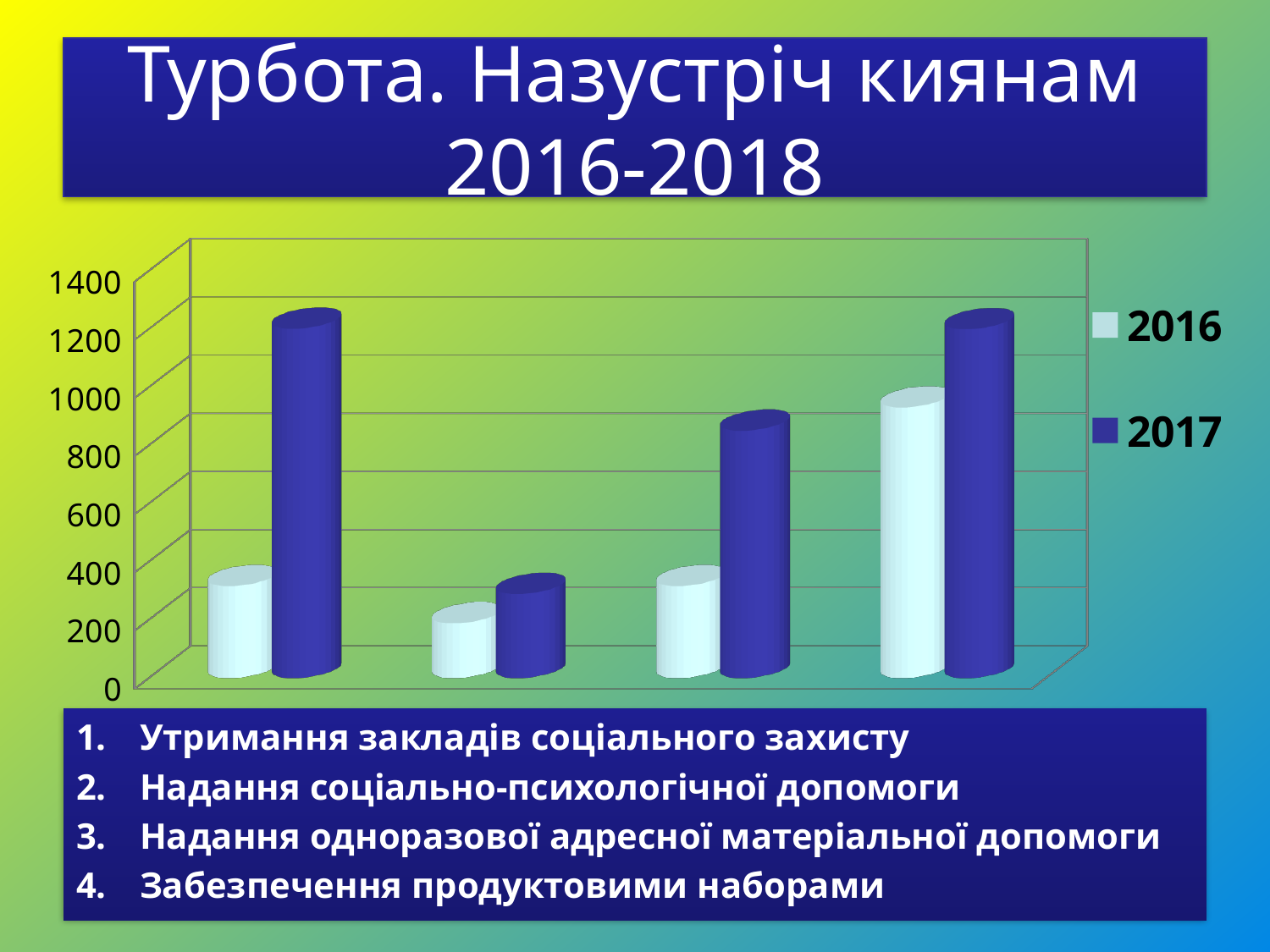
Which years are listed in the chart legend? 2016 and 2017 Which category has the lowest 2017 value? Надання соціально-психологічної допомоги (category 2) What kind of chart is shown on the slide? bar chart Is the 2016 value for the fourth category (Забезпечення продуктовими наборами) greater or less than 800? greater Is the 2017 value for the first category (Утримання закладів соціального захисту) greater or less than 1000? greater For the first category (Утримання закладів соціального захисту), which year has the larger value, 2016 or 2017? 2017 How many series does the chart legend list? 2 How many groups of bars (categories) are plotted in the chart? 4 Which series is shown in dark blue in the chart? 2017 Is the 2017 value for the third category (Надання одноразової адресної матеріальної допомоги) greater or less than 600? greater Which category has the highest 2016 value? Забезпечення продуктовими наборами (category 4)